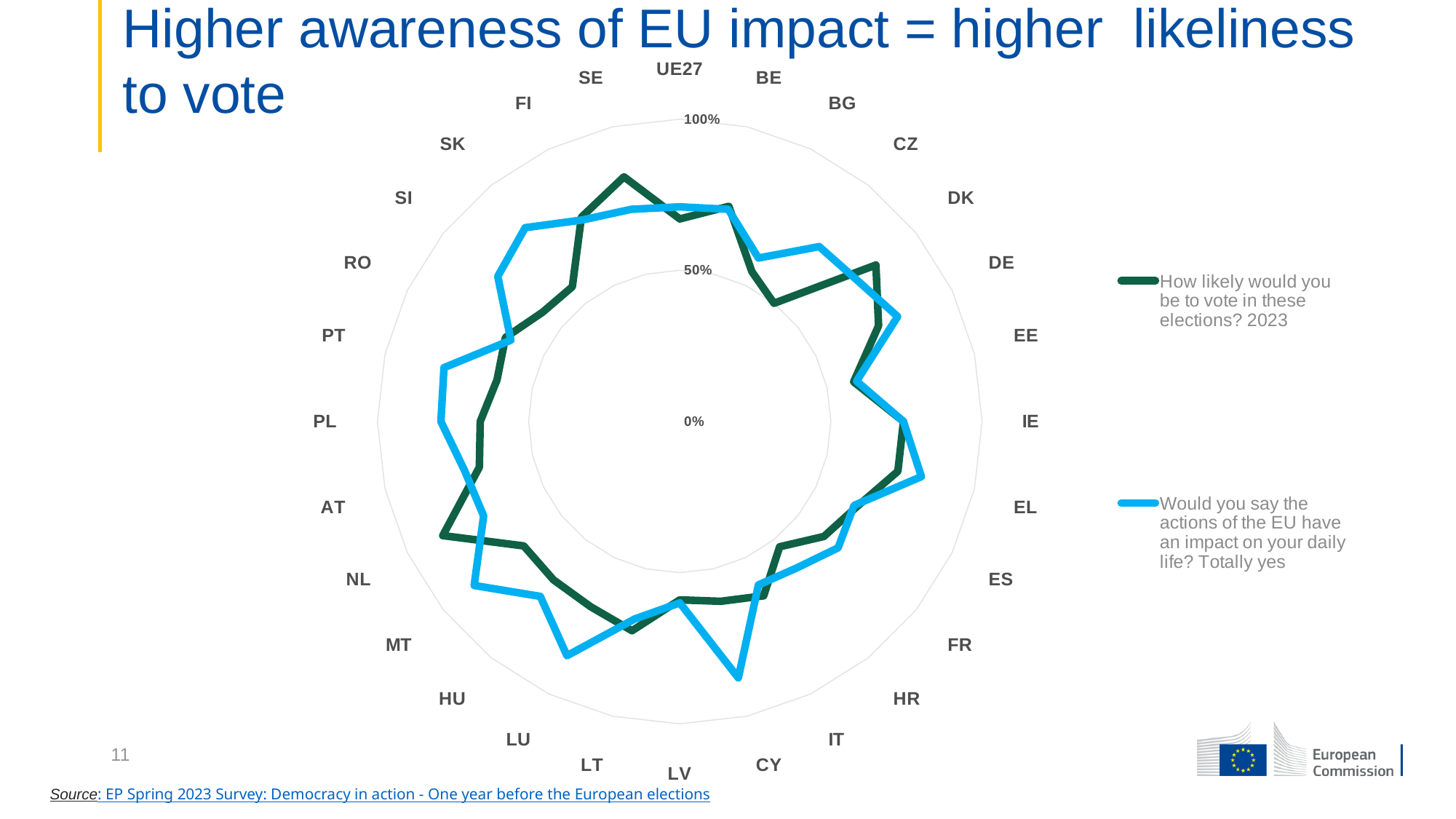
What is the highest percentage tick labelled on the radar chart's axis? 100% What kind of chart is shown on the slide? Radar chart Is the value for NL on the 'How likely would you be to vote in these elections? 2023' series greater or less than 50%? greater For SE, which series has the larger value: 'How likely would you be to vote in these elections? 2023' or 'Would you say the actions of the EU have an impact on your daily life? Totally yes'? How likely would you be to vote in these elections? 2023 Is the value for PT on the 'Would you say the actions of the EU have an impact on your daily life? Totally yes' series greater or less than 50%? greater What colour is the line for the 'How likely would you be to vote in these elections? 2023' series? Dark green Is the value for UE27 on the 'How likely would you be to vote in these elections? 2023' series greater or less than 50%? greater For SK, which series has the larger value: 'How likely would you be to vote in these elections? 2023' or 'Would you say the actions of the EU have an impact on your daily life? Totally yes'? Would you say the actions of the EU have an impact on your daily life? Totally yes How many series does the legend list? 2 How many categories (countries plus UE27) are plotted around the radar chart? 28